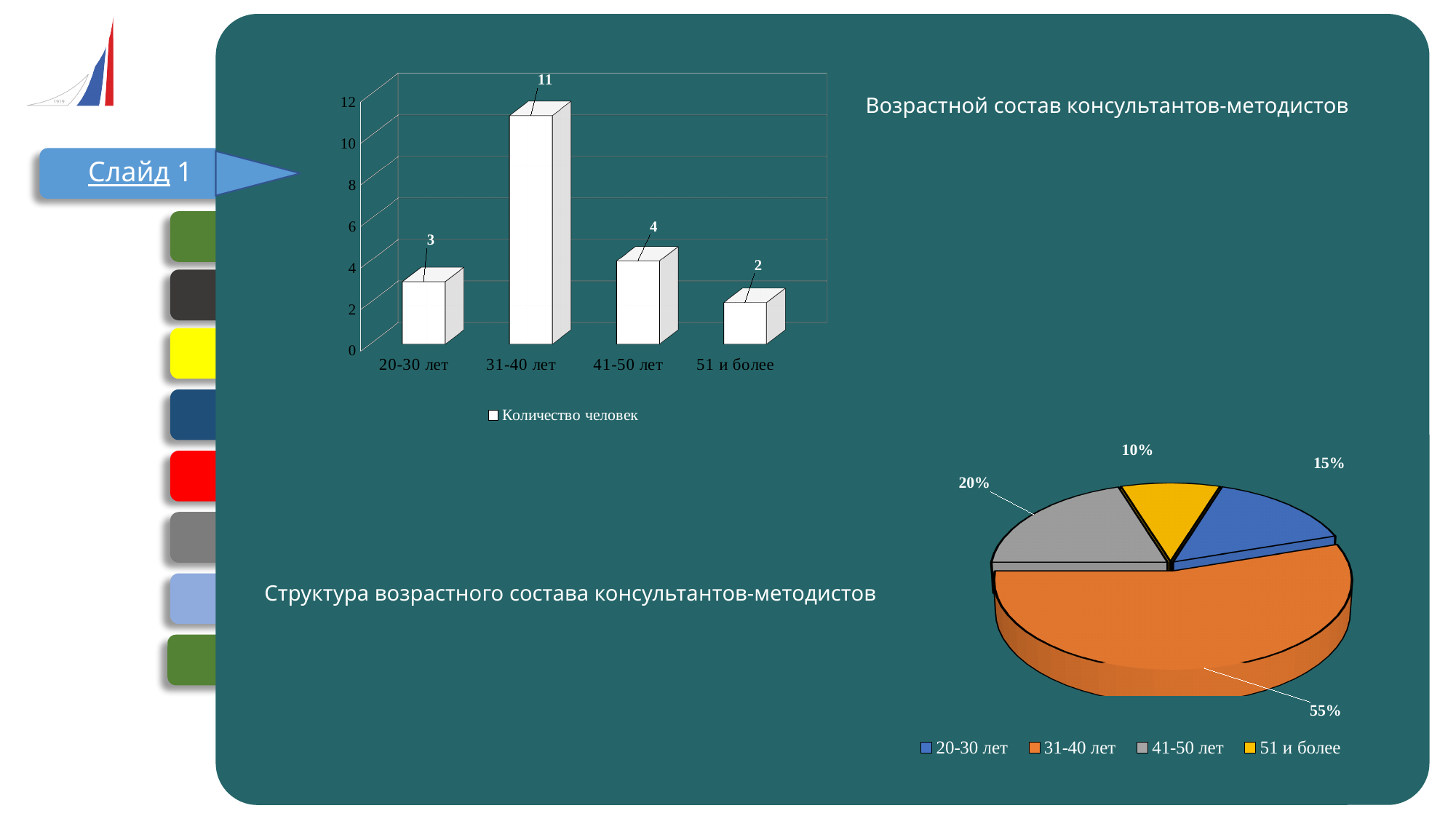
In the bar chart 'Возрастной состав консультантов-методистов', what is the value for 31-40 лет? 11 In the pie chart 'Структура возрастного состава консультантов-методистов', which colour represents 41-50 лет? Gray What type of chart is 'Возрастной состав консультантов-методистов'? Bar chart What is the legend entry of the bar chart 'Возрастной состав консультантов-методистов'? Количество человек In the bar chart 'Возрастной состав консультантов-методистов', what is the value for 51 и более? 2 In the bar chart 'Возрастной состав консультантов-методистов', which is larger: the value for 20-30 лет or 41-50 лет? 41-50 лет In the pie chart 'Структура возрастного состава консультантов-методистов', what share does 31-40 лет have? 55% In the pie chart 'Структура возрастного состава консультантов-методистов', what share does 51 и более have? 10% In the bar chart 'Возрастной состав консультантов-методистов', which age group has the highest value? 31-40 лет In the bar chart 'Возрастной состав консультантов-методистов', which age group has the lowest value? 51 и более How many age categories are shown in the bar chart 'Возрастной состав консультантов-методистов'? 4 In the bar chart 'Возрастной состав консультантов-методистов', what is the difference between the values for 31-40 лет and 41-50 лет? 7